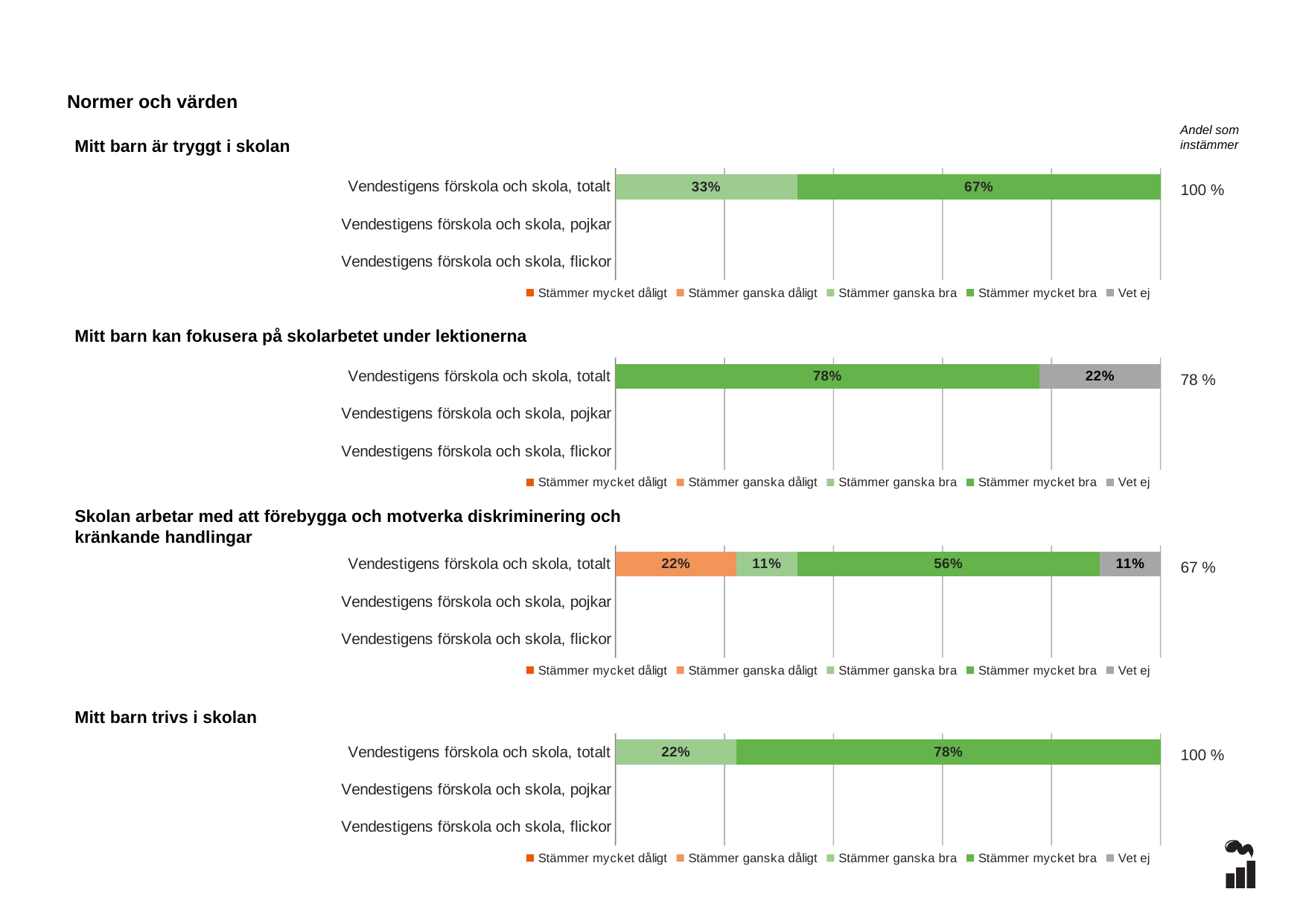
In the chart 'Mitt barn kan fokusera på skolarbetet under lektionerna', what is the difference between the 'Stämmer mycket bra' and 'Vet ej' values for Vendestigens förskola och skola, totalt? 56 percentage points In the chart 'Mitt barn är tryggt i skolan', what is the value for 'Stämmer ganska bra' for Vendestigens förskola och skola, totalt? 33% In the chart 'Skolan arbetar med att förebygga och motverka diskriminering och kränkande handlingar', what is the 'Andel som instämmer' shown for Vendestigens förskola och skola, totalt? 67 % What kind of chart is 'Mitt barn kan fokusera på skolarbetet under lektionerna'? Stacked bar chart How many categories are shown on the y axis of the chart 'Mitt barn trivs i skolan'? 3 In the chart 'Mitt barn kan fokusera på skolarbetet under lektionerna', what is the value for 'Vet ej' for Vendestigens förskola och skola, totalt? 22% In the chart 'Skolan arbetar med att förebygga och motverka diskriminering och kränkande handlingar', what is the value for 'Stämmer ganska dåligt' for Vendestigens förskola och skola, totalt? 22% In the chart 'Skolan arbetar med att förebygga och motverka diskriminering och kränkande handlingar', which response category has the largest share for Vendestigens förskola och skola, totalt? Stämmer mycket bra In the chart 'Mitt barn trivs i skolan', what is the value for 'Stämmer mycket bra' for Vendestigens förskola och skola, totalt? 78% How many series does the legend list in the chart 'Mitt barn är tryggt i skolan'? 5 In the chart 'Mitt barn är tryggt i skolan', what is the value for 'Stämmer mycket bra' for Vendestigens förskola och skola, totalt? 67% In the chart 'Mitt barn trivs i skolan', which is larger for Vendestigens förskola och skola, totalt: 'Stämmer ganska bra' or 'Stämmer mycket bra'? Stämmer mycket bra